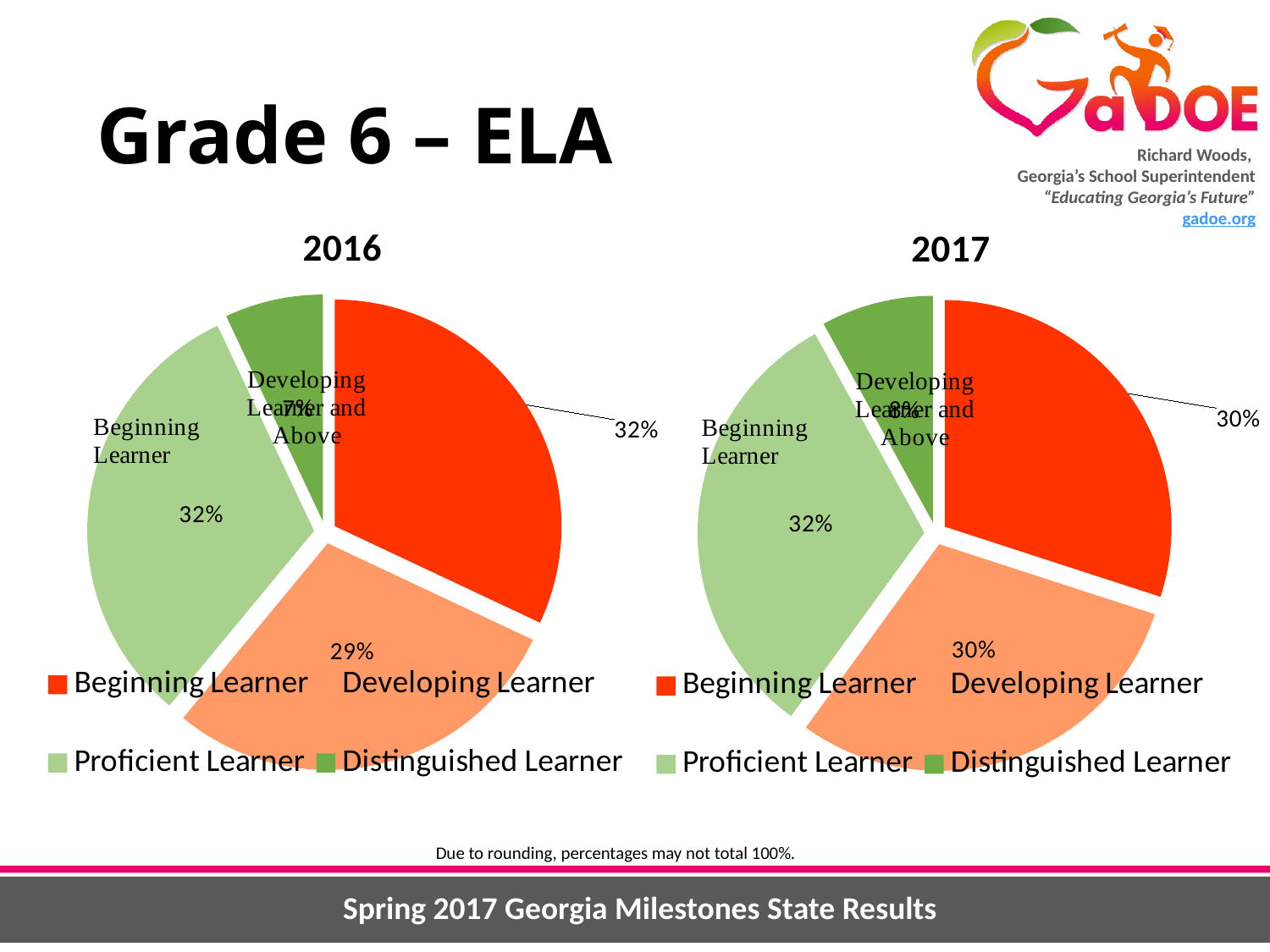
In the 2017 pie chart, what percentage is shown for Proficient Learner? 32% In the 2016 pie chart, what percentage is shown for Beginning Learner? 32% In the 2017 pie chart, which category has the largest share? Proficient Learner In the 2016 pie chart, what percentage is shown for Developing Learner? 29% In the 2016 pie chart, which category has the smallest share? Distinguished Learner How many categories does the legend of the 2016 pie chart list? 4 What colour represents Beginning Learner in the legend of the 2016 chart? red In the 2017 pie chart, what percentage is shown for Beginning Learner? 30% In the 2017 pie chart, is the share for Proficient Learner larger or smaller than the share for Developing Learner? larger What type of chart is used to show the 2017 results? pie chart In the 2017 pie chart, what percentage is shown for Developing Learner? 30% In the 2016 pie chart, what is the difference between the Beginning Learner share and the Developing Learner share? 3%